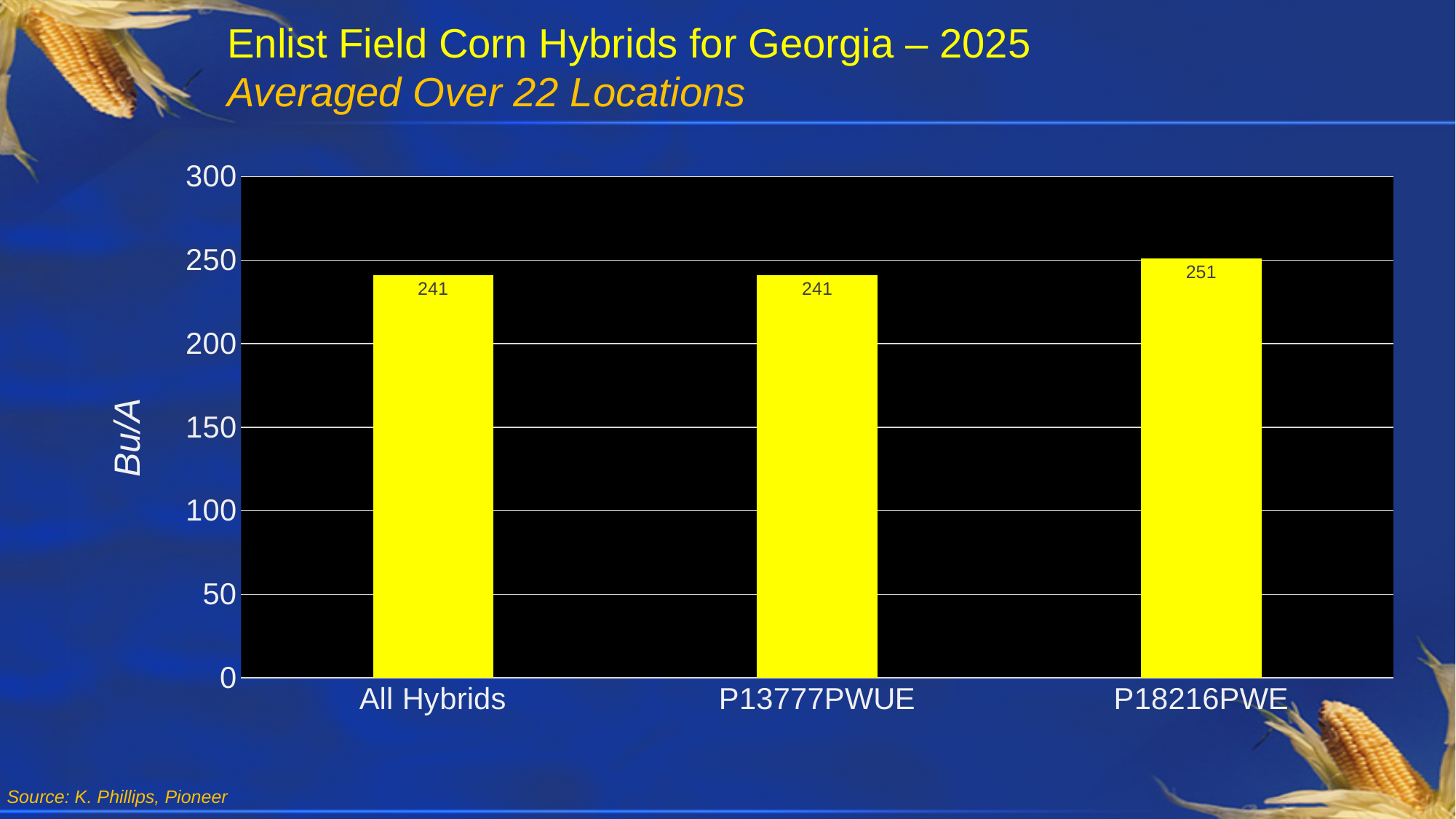
What is the difference between the values for P18216PWE and All Hybrids? 10 Is the value for P18216PWE greater or less than 300? less Which is larger, the value for P18216PWE or the value for P13777PWUE? P18216PWE What is the value for P18216PWE? 251 What is the label on the y axis? Bu/A How many categories are shown on the x axis? 3 What colour are the bars in the chart? yellow What is the value for P13777PWUE? 241 Is the value for All Hybrids greater or less than 200? greater Which category has the highest value? P18216PWE What is the value for All Hybrids? 241 What kind of chart is shown on the slide? bar chart